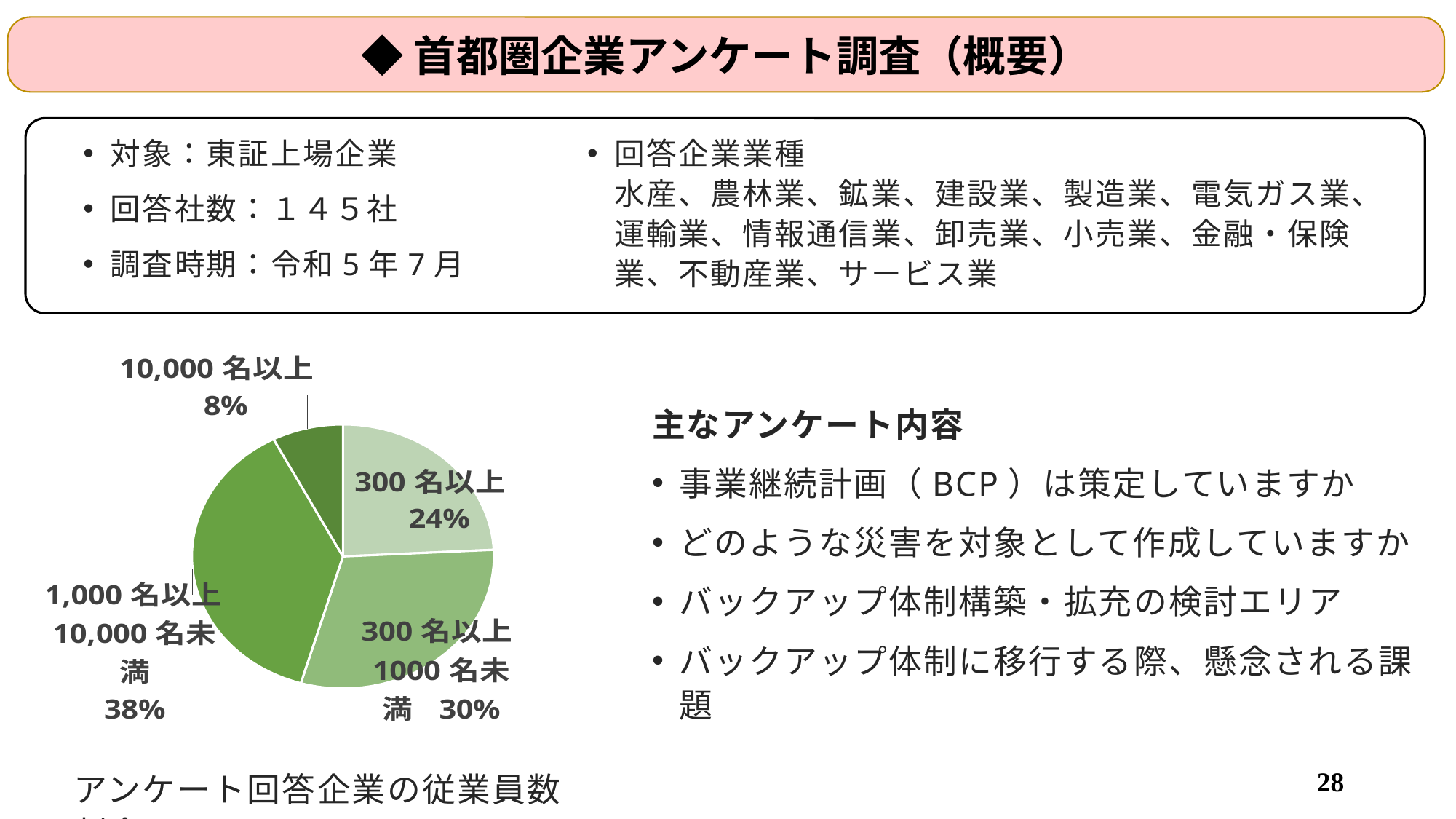
What share of the pie chart is the 10,000 名以上 slice? 8% How many slices does the pie chart have? 4 What colour scheme is used for the slices of the pie chart? Shades of green Which slice of the pie chart is the smallest? 10,000 名以上 Which slice of the pie chart is the largest? 1,000 名以上 10,000 名未満 What is the difference between the 300 名以上 1000 名未満 slice (30%) and the slice labeled 24%? 6 percentage points Which is larger in the pie chart: the 300 名以上 1000 名未満 slice or the 10,000 名以上 slice? 300 名以上 1000 名未満 What is the combined share of the 10,000 名以上 and 1,000 名以上 10,000 名未満 slices? 46% What share of the pie chart is the 300 名以上 1000 名未満 slice? 30% What share of the pie chart is the 1,000 名以上 10,000 名未満 slice? 38% By how many percentage points does the 1,000 名以上 10,000 名未満 slice exceed the 10,000 名以上 slice? 30 percentage points What kind of chart is shown on the slide? Pie chart